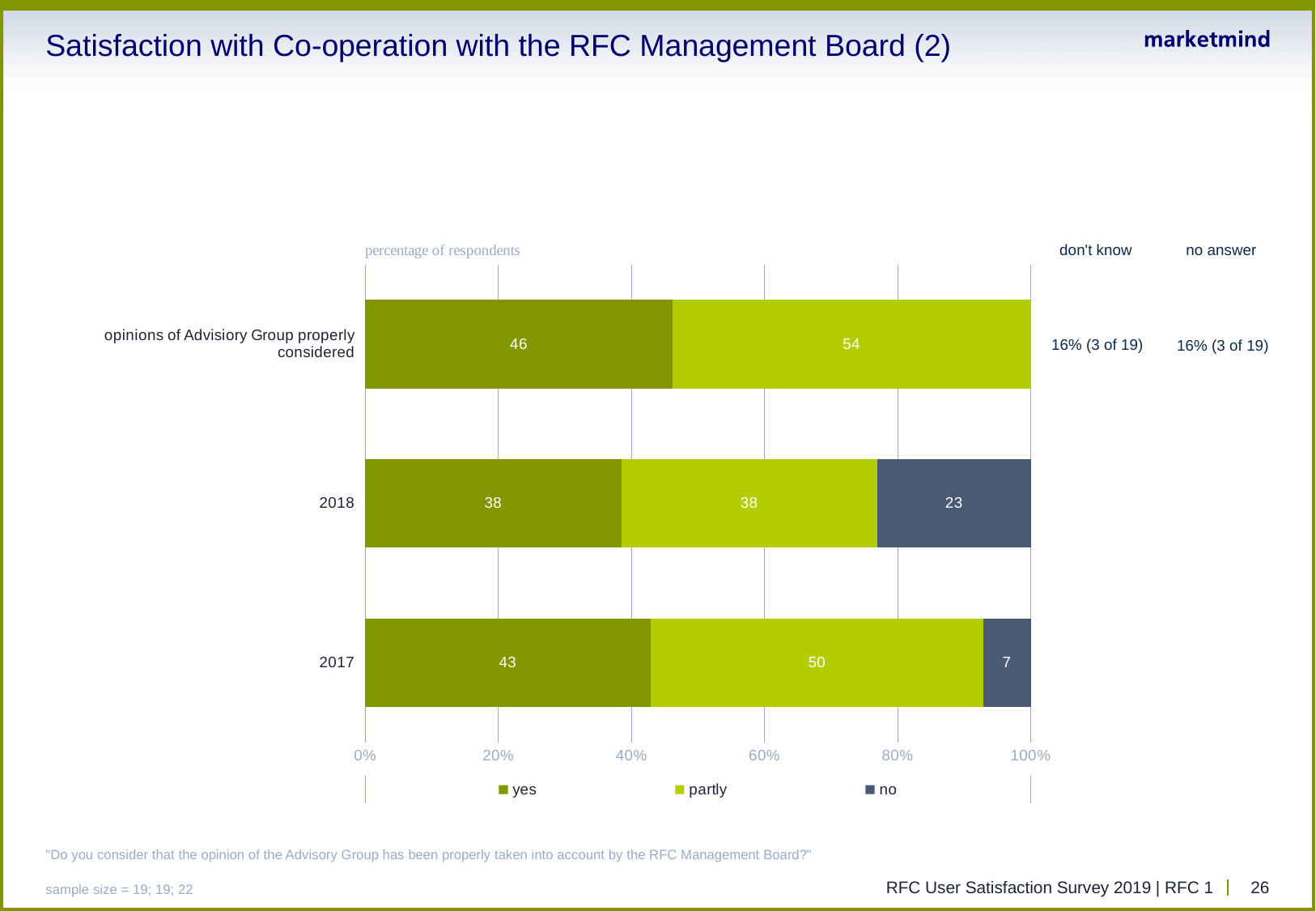
Is the "partly" value larger for 2017 or for 2018? 2017 What is the "no" value for the 2017 bar? 7 What is the "partly" value for the 2017 bar? 50 How many series does the legend list? 3 Which bar has the highest "yes" value? opinions of Advisiory Group properly considered What is the "don't know" value shown for the bar labelled "opinions of Advisiory Group properly considered"? 16% (3 of 19) What is the difference between the "no" values for 2018 and 2017? 16 What percentage of respondents answered "yes" in 2018? 38 Which bar has the highest "no" value? 2018 What kind of chart is shown on the slide? stacked bar chart What are the three legend entries of the chart? yes, partly, no What is the "yes" value for the bar labelled "opinions of Advisiory Group properly considered"? 46